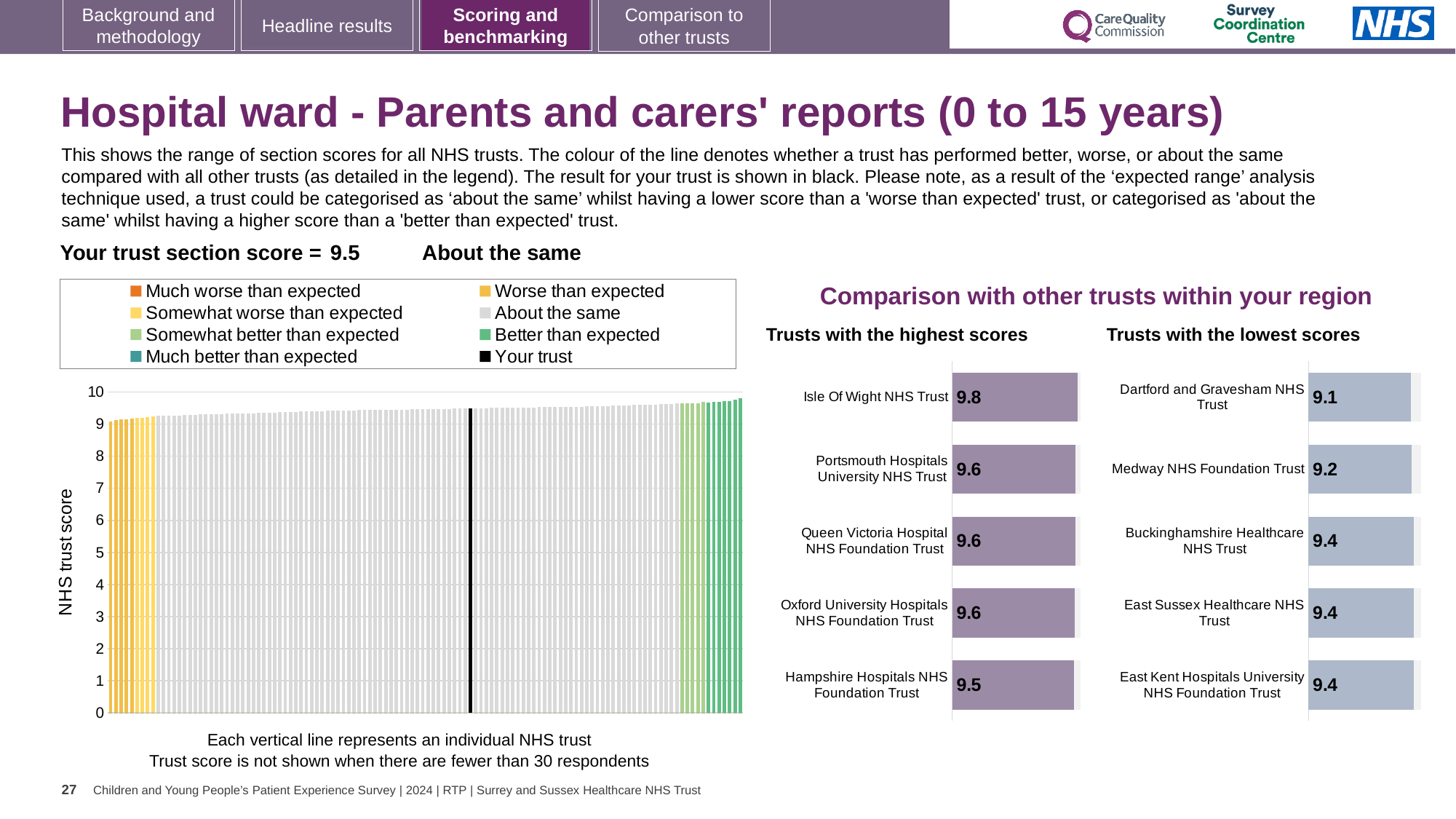
In the 'Trusts with the lowest scores' chart, what is the difference between the scores of Medway NHS Foundation Trust and Dartford and Gravesham NHS Trust? 0.1 In the 'Trusts with the highest scores' chart, which trust has the highest score? Isle Of Wight NHS Trust In the 'Trusts with the lowest scores' chart, which has the larger score: Medway NHS Foundation Trust or Buckinghamshire Healthcare NHS Trust? Buckinghamshire Healthcare NHS Trust In the 'Trusts with the highest scores' chart, how many trusts are listed? 5 In the 'Trusts with the highest scores' chart, what is the score for Isle Of Wight NHS Trust? 9.8 How many entries does the legend above the large chart on the left list? 8 In the large chart on the left, do the trust scores rise or fall from left to right along the x axis? Rise In the 'Trusts with the lowest scores' chart, what is the score for Dartford and Gravesham NHS Trust? 9.1 In the 'Trusts with the highest scores' chart, what is the score for Hampshire Hospitals NHS Foundation Trust? 9.5 In the 'Trusts with the lowest scores' chart, which trust has the lowest score? Dartford and Gravesham NHS Trust What kind of chart is the large chart on the left showing NHS trust scores? Bar chart In the 'Trusts with the highest scores' chart, what is the difference between the scores of Isle Of Wight NHS Trust and Hampshire Hospitals NHS Foundation Trust? 0.3